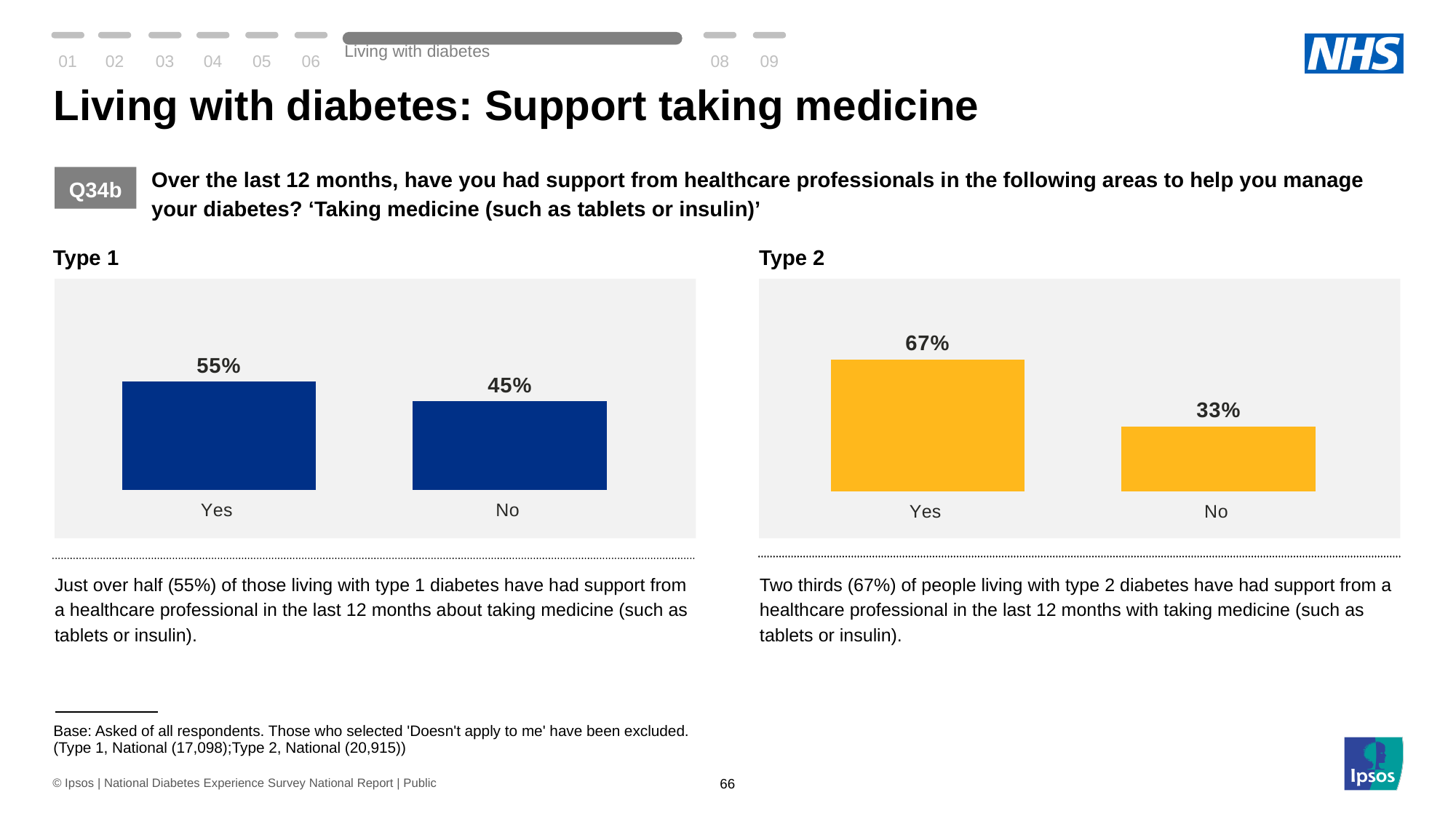
How many categories are shown in the Type 1 chart? 2 In the Type 2 chart, what is the difference between the Yes and No percentages? 34% In the Type 1 chart, what percentage answered Yes? 55% In the Type 1 chart, which category has the lowest value? No In the Type 2 chart, which category has the highest value? Yes In the Type 1 chart, what is the difference between the Yes and No percentages? 10% What colour are the bars in the Type 2 chart? Yellow In the Type 1 chart, what percentage answered No? 45% Which is larger: the Yes value in the Type 1 chart or the Yes value in the Type 2 chart? Type 2 In the Type 2 chart, what percentage answered No? 33% In the Type 2 chart, what percentage answered Yes? 67% What kind of chart is the Type 2 chart? Bar chart